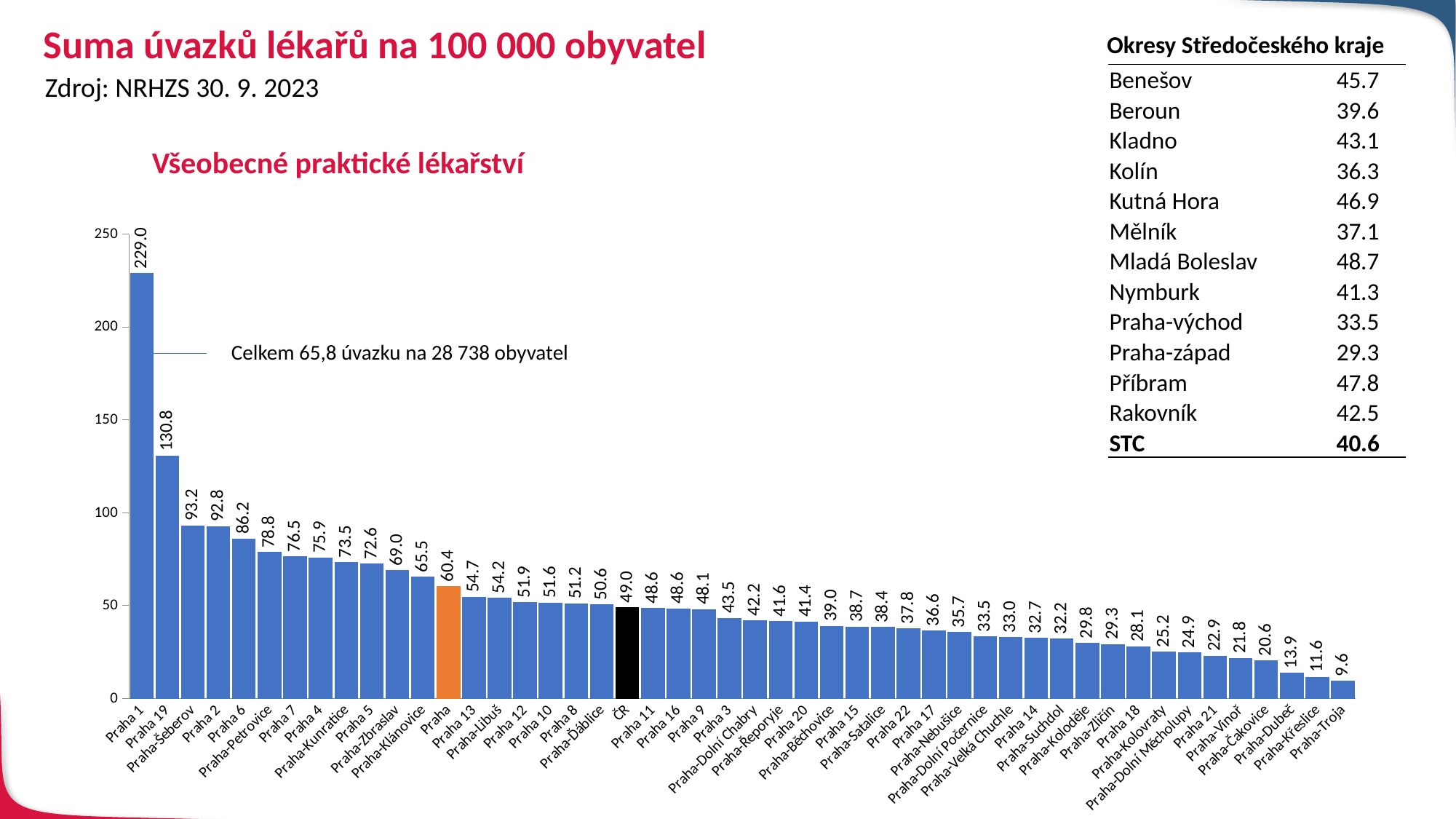
What is the difference between the values for Praha 1 and Praha 19? 98.2 What is the value for Praha 1 in the chart? 229.0 Do the values rise or fall from left to right along the x axis? fall Which category has the lowest value in the chart? Praha-Troja What colour is the bar for Praha in the chart? orange What is the difference between the values for Praha and ČR? 11.4 What type of chart is shown on the slide? bar chart Which has a larger value, Praha 6 or Praha 4? Praha 6 What is the value for Praha-Šeberov in the chart? 93.2 What is the value for ČR in the chart? 49.0 Which category has the highest value in the chart? Praha 1 What is the value for Praha-Troja in the chart? 9.6